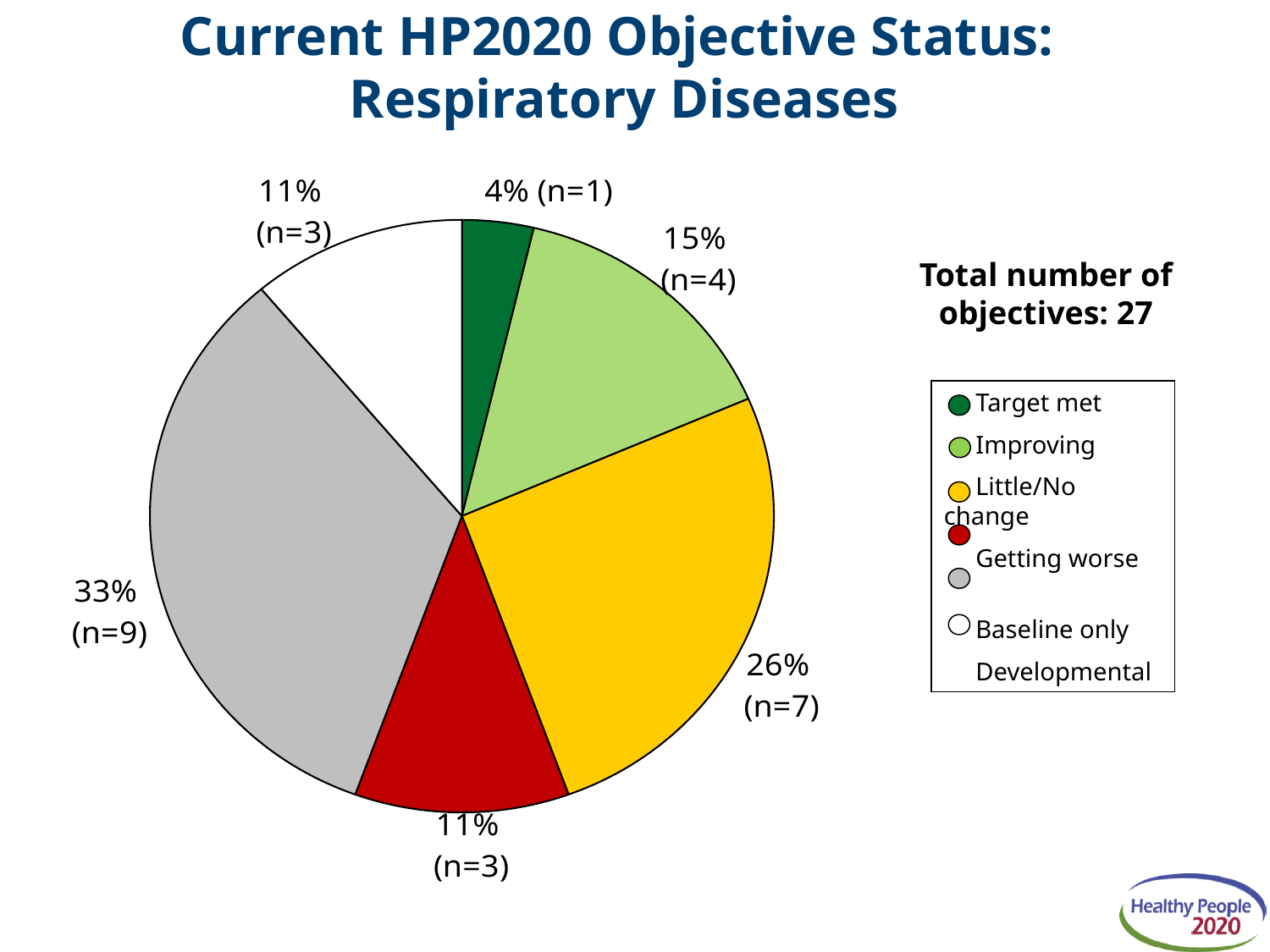
Which has more objectives, Improving or Getting worse? Improving What percentage of Respiratory Diseases objectives have Little/No change? 26% What is the difference in percentage points between the Baseline only and Little/No change slices? 7 What type of chart is shown on the slide? Pie chart What is the total number of objectives stated on the slide? 27 What percentage of objectives have met their target? 4% Which status category has the largest share of objectives? Baseline only How many objectives are in the Baseline only category? 9 How many objectives are Improving? 4 How many status categories are shown in the pie chart? 6 What colour represents the Getting worse category in the pie chart? Red Which status category has the smallest share of objectives? Target met